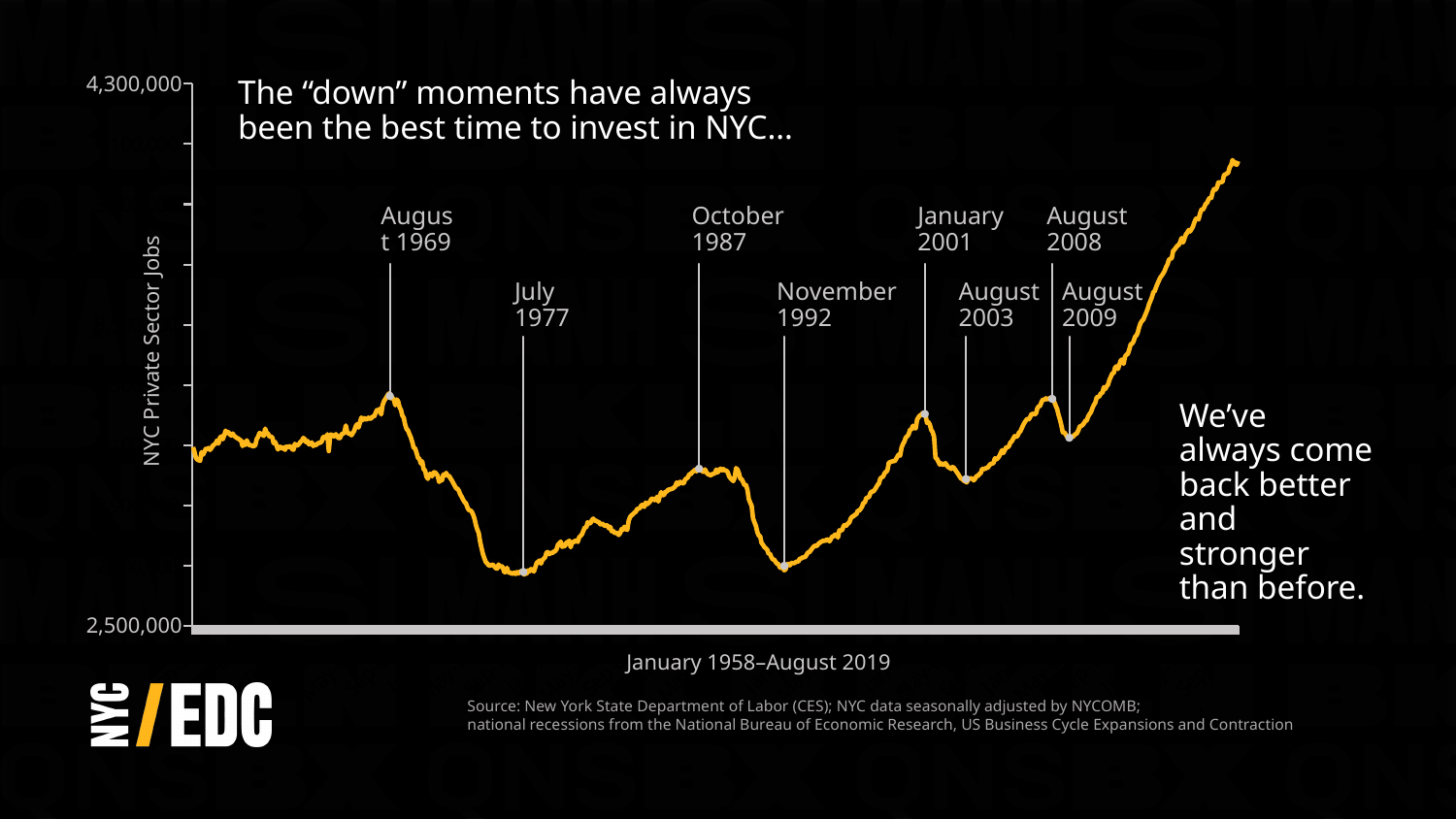
What is the label on the vertical axis of the chart? NYC Private Sector Jobs Overall, do NYC private sector jobs rise or fall from the start of the chart to the end? rise What is the highest value shown on the vertical axis? 4,300,000 Which is higher, the value at October 1987 or the value at November 1992? October 1987 Which is higher, the value at August 1969 or the value at July 1977? August 1969 Which is higher, the value at August 2008 or the value at August 2009? August 2008 What is the lowest value shown on the vertical axis? 2,500,000 What time period does the chart cover, according to the label below the x axis? January 1958–August 2019 How many dated points are annotated on the line? 8 Is the value at July 1977 greater or less than 2,500,000? greater What kind of chart is shown on the slide? line chart Is the value at the end of the line (August 2019) greater or less than 4,300,000? less